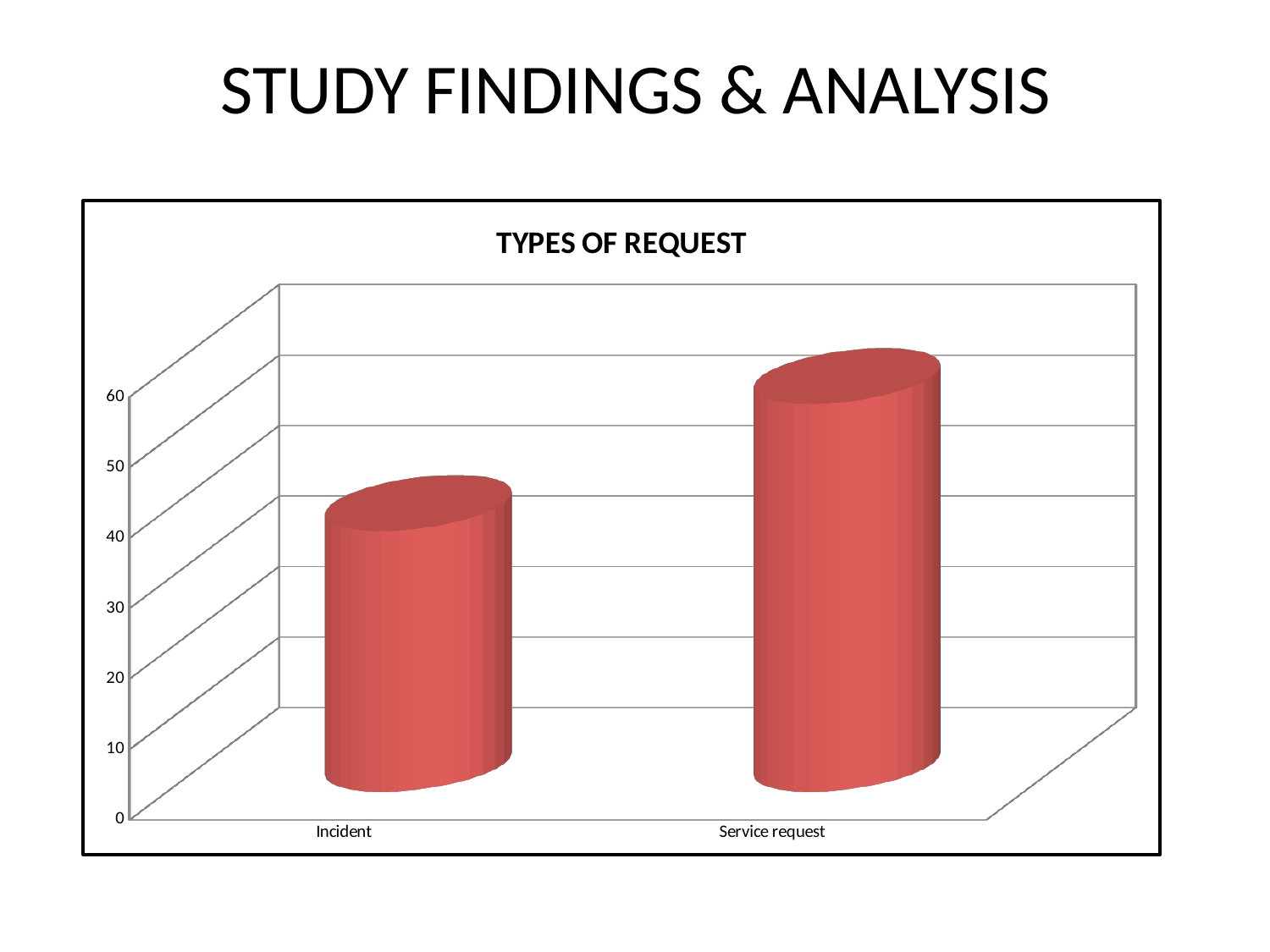
What is the highest tick value shown on the vertical axis of the chart? 60 Which category has the lowest value in the chart? Incident What kind of chart is shown on the slide? bar chart Which is larger, the value for Incident or the value for Service request? Service request How many categories are shown on the x axis of the chart? 2 Is the value for Incident greater or less than 50? less Is the value for Service request greater or less than 40? greater Is the value for Service request greater or less than 30? greater What is the title of the chart? TYPES OF REQUEST Do the values rise or fall from Incident to Service request along the x axis? rise Which category has the highest value in the chart? Service request